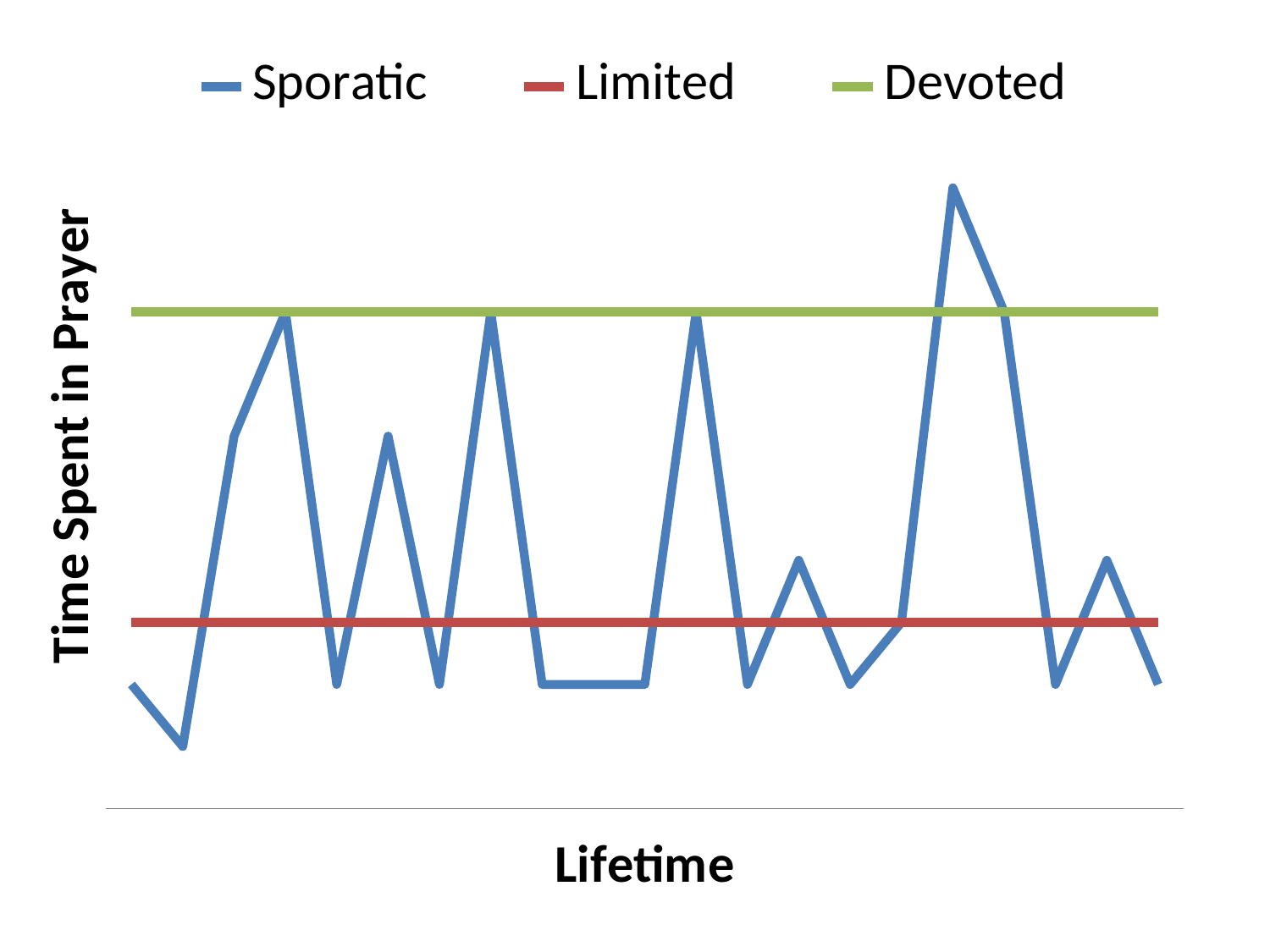
What is the title of the horizontal axis? Lifetime Which of the two flat lines, Limited or Devoted, is higher? Devoted Does the Devoted series rise, fall, or stay flat along the x axis? stay flat Which series reaches the lowest point on the chart? Sporatic What kind of chart is shown on the slide? line chart What is the title of the vertical axis? Time Spent in Prayer Which series reaches the single highest point on the chart? Sporatic How many series does the legend list? 3 Does the Limited series rise, fall, or stay flat along the x axis? stay flat Which series fluctuates up and down across the chart rather than staying constant? Sporatic Which series is drawn as a flat line at the highest level across the chart? Devoted